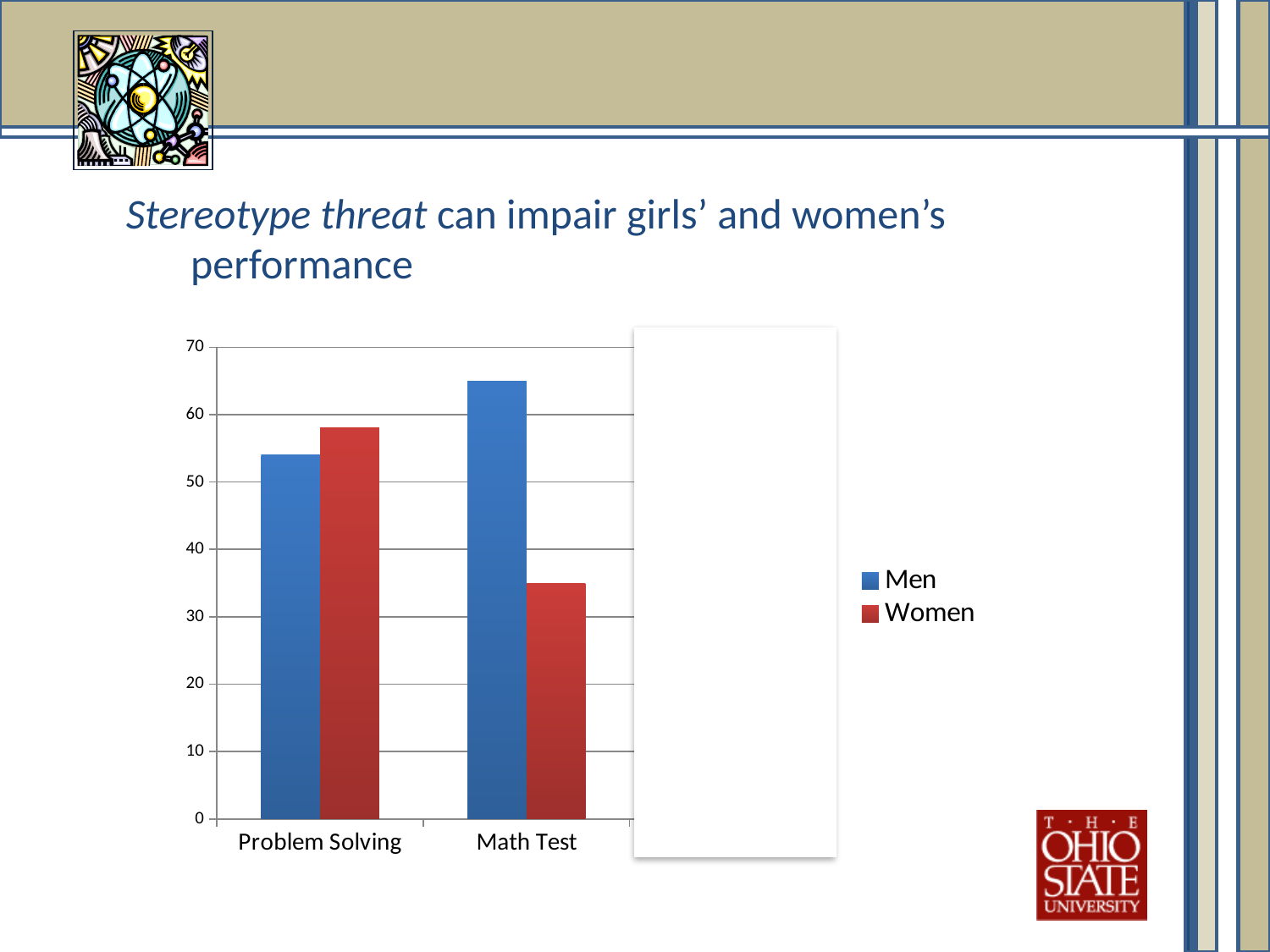
How many series does the legend list? 2 Is the value for Men on Problem Solving greater or less than 50? greater Is the value for Men on the Math Test greater or less than 60? greater Is the value for Women on the Math Test greater or less than 40? less On the Math Test, which group has the larger value, Men or Women? Men Which colour represents Women in the chart? red What are the two series named in the legend? Men and Women What kind of chart is shown on the slide? bar chart For the Women series, which category has the lower value? Math Test For the Men series, which category has the higher value? Math Test